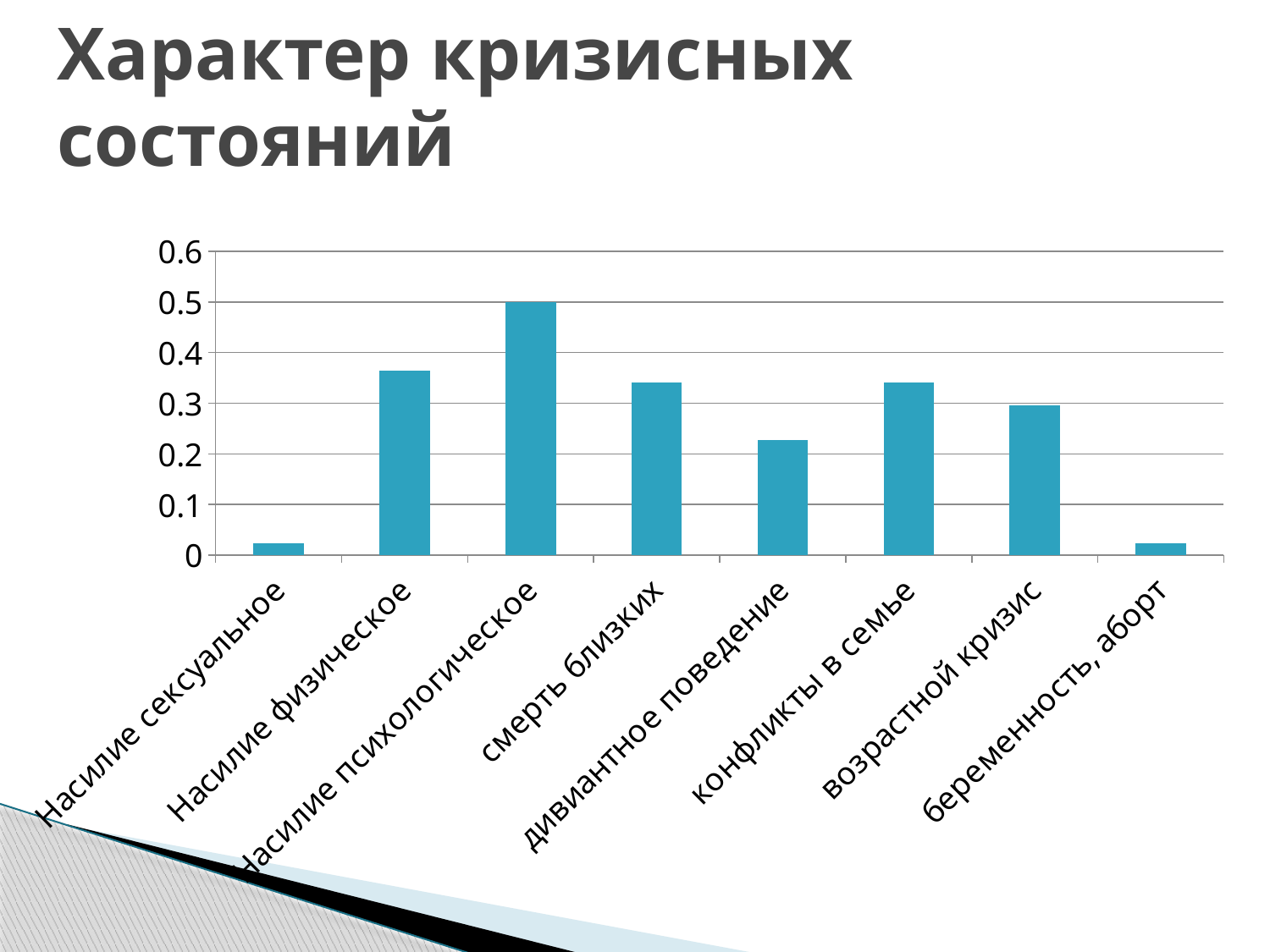
How many categories are shown on the x axis of the chart? 8 Which is larger, the value for Насилие физическое or the value for дивиантное поведение? Насилие физическое What is the title of the slide containing the chart? Характер кризисных состояний Which category has the highest value in the chart? Насилие психологическое What is the value for Насилие психологическое? 0.5 What kind of chart is shown on the slide? Bar chart Is the value for Насилие сексуальное greater or less than 0.1? less Is the value for конфликты в семье greater or less than 0.3? greater Is the value for дивиантное поведение greater or less than 0.3? less Which is larger, the value for возрастной кризис or the value for дивиантное поведение? возрастной кризис